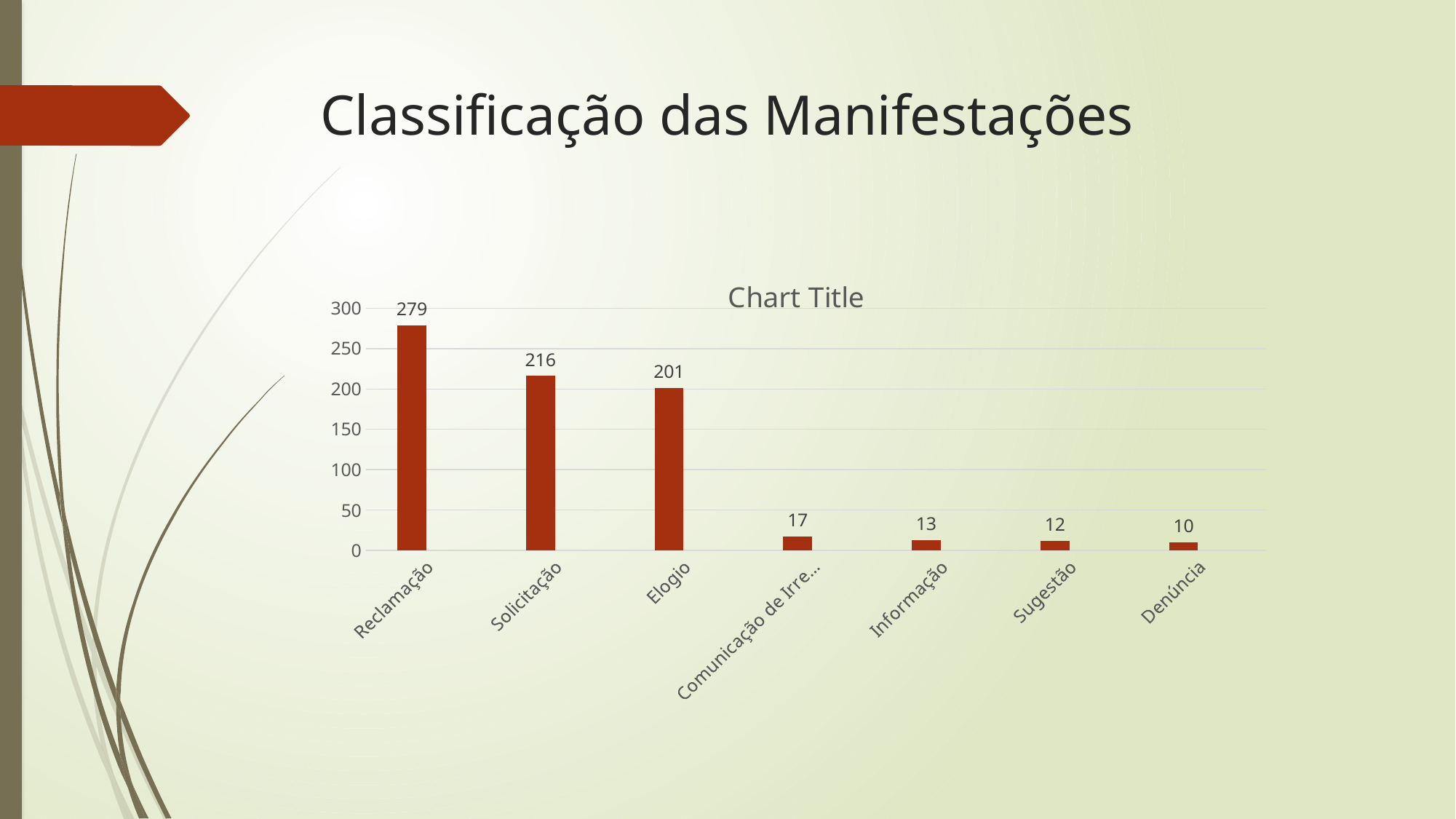
What kind of chart is shown on the slide? Bar chart What is the title of the slide? Classificação das Manifestações Which category has the lowest value? Denúncia How many categories are shown on the x axis? 7 What is the value for Elogio? 201 What is the value for Informação? 13 What is the value for Reclamação? 279 What is the value for Denúncia? 10 Which is larger, the value for Sugestão or the value for Informação? Informação Which category has the highest value? Reclamação What is the difference between the values for Reclamação and Solicitação? 63 What is the value for Solicitação? 216